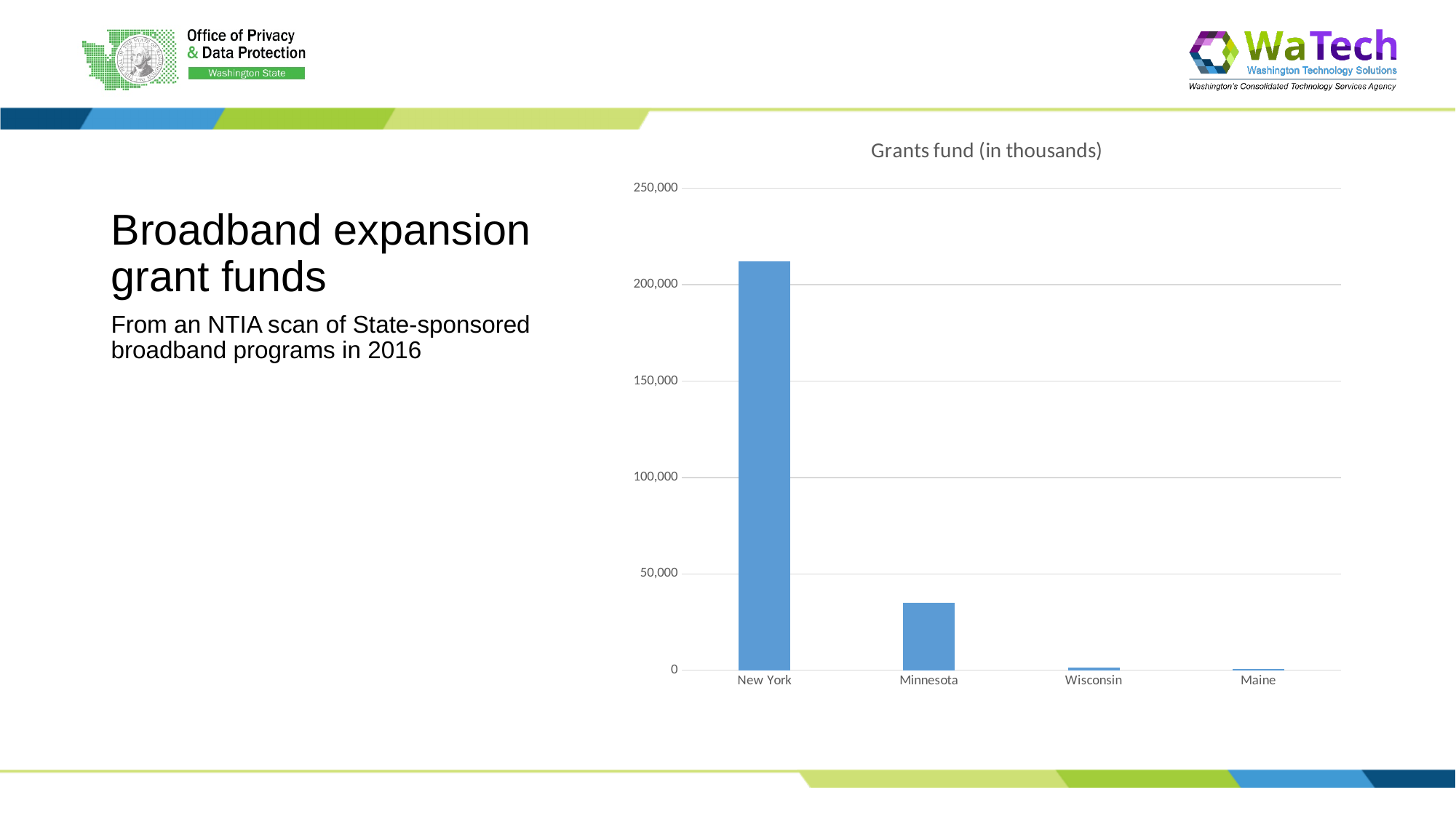
Which has a larger grants fund value, New York or Minnesota? New York Is the grants fund value for New York greater or less than 250,000? less What is the highest value labelled on the vertical axis of the chart? 250,000 Which has a larger grants fund value, Minnesota or Wisconsin? Minnesota What kind of chart is shown on the slide? bar chart Is the grants fund value for New York greater or less than 200,000? greater Which state has the highest grants fund value in the chart? New York What is the title of the chart? Grants fund (in thousands) Is the grants fund value for Minnesota greater or less than 50,000? less Do the grants fund values rise or fall moving from New York to Maine along the x axis? fall How many states are shown on the x axis of the chart? 4